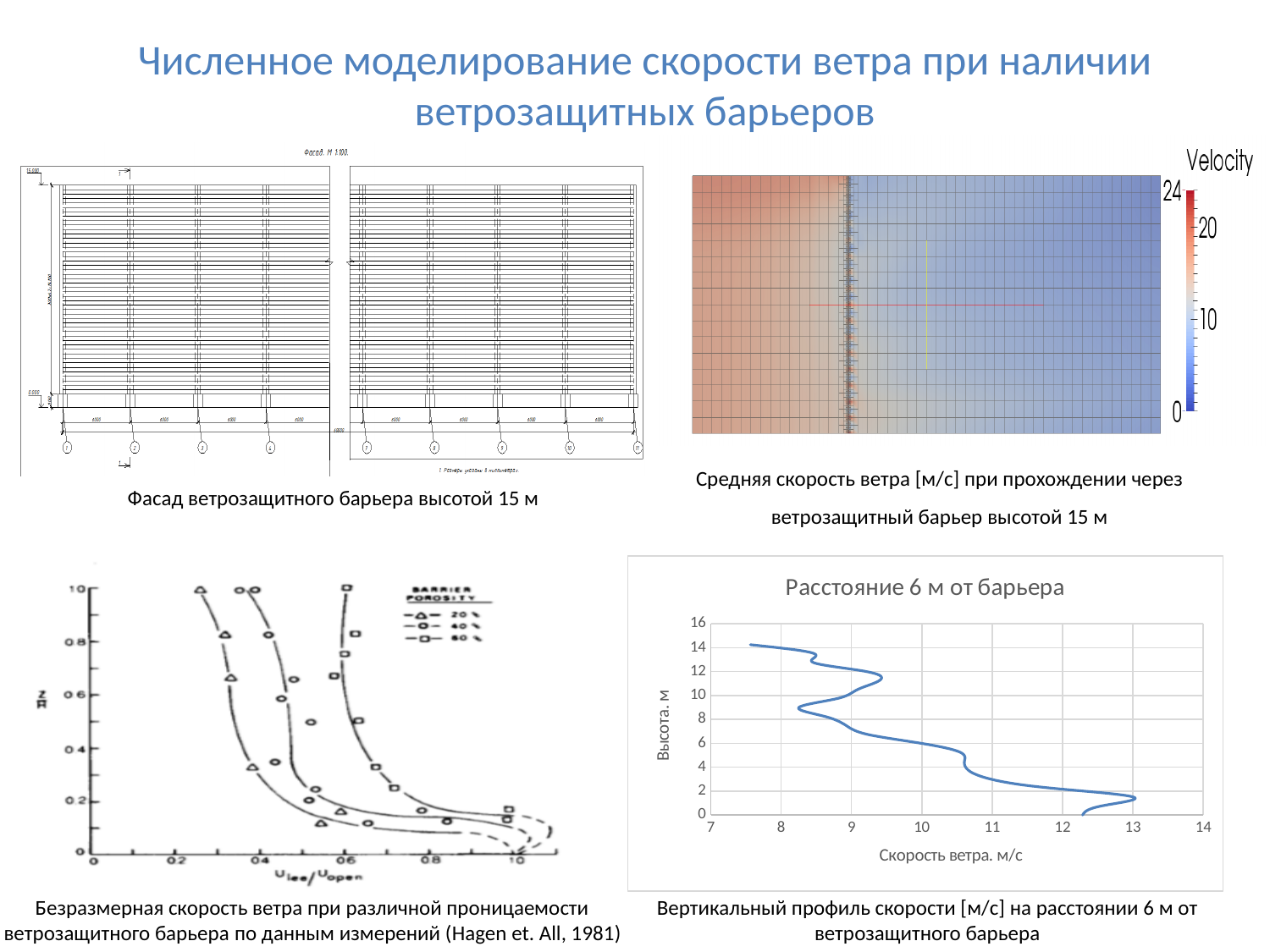
In the chart "Расстояние 6 м от барьера", is the wind speed at a height of 2 m greater or less than 12 m/s? greater In the chart "Расстояние 6 м от барьера", what is the label of the horizontal axis? Скорость ветра. м/с In the top-right velocity map, what is the maximum value shown on the Velocity colour scale? 24 What is the title of the chart in the bottom-right of the slide? Расстояние 6 м от барьера In the chart "Расстояние 6 м от барьера", what is the maximum value shown on the horizontal axis? 14 In the chart "Расстояние 6 м от барьера", is the wind speed at a height of 9 m greater or less than 9 m/s? less In the chart "Расстояние 6 м от барьера", does the wind speed generally increase or decrease as height increases? decrease In the bottom-left chart (Hagen et al., 1981), which barrier porosity has the larger dimensionless velocity at z/H = 1: 20% or 60%? 60% In the bottom-left chart (Hagen et al., 1981), how many barrier porosity series does the legend list? 3 What kind of chart is the chart titled "Расстояние 6 м от барьера"? line chart In the chart "Расстояние 6 м от барьера", is the wind speed at a height of 4 m greater or less than 10 m/s? greater